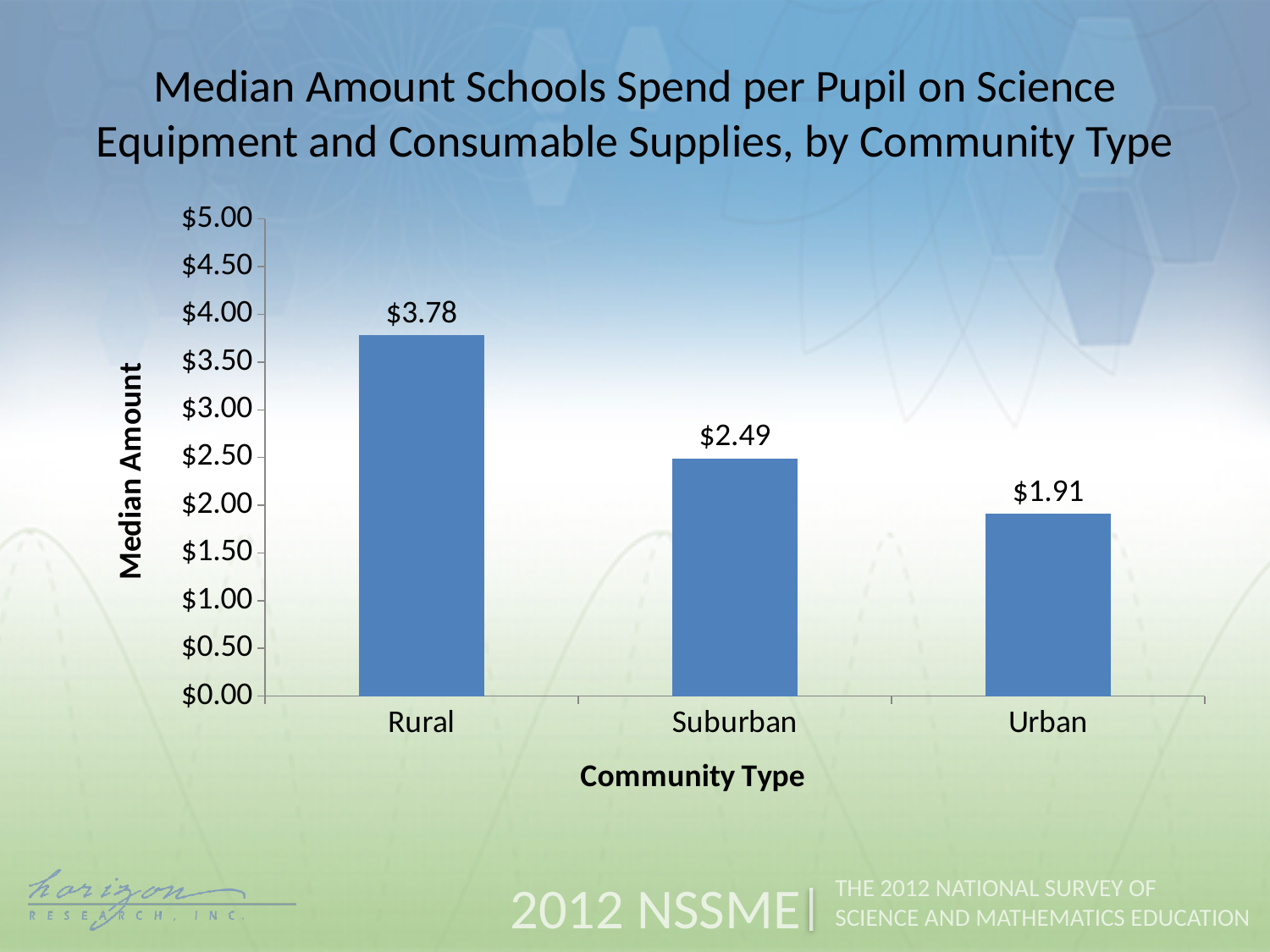
What kind of chart is shown on the slide? Bar chart Is the value for Suburban greater or less than $3.00? less What is the difference between the median amounts for Rural and Urban schools? $1.87 Which community type has the lowest median amount spent per pupil? Urban How many community types are shown on the chart? 3 What is the median amount spent per pupil for Rural schools? $3.78 What is the median amount spent per pupil for Urban schools? $1.91 Which is larger, the median amount for Suburban or Urban schools? Suburban Do the values rise or fall moving from Rural to Urban along the x axis? Fall Which community type has the highest median amount spent per pupil? Rural What is the difference between the median amounts for Rural and Suburban schools? $1.29 What is the median amount spent per pupil for Suburban schools? $2.49